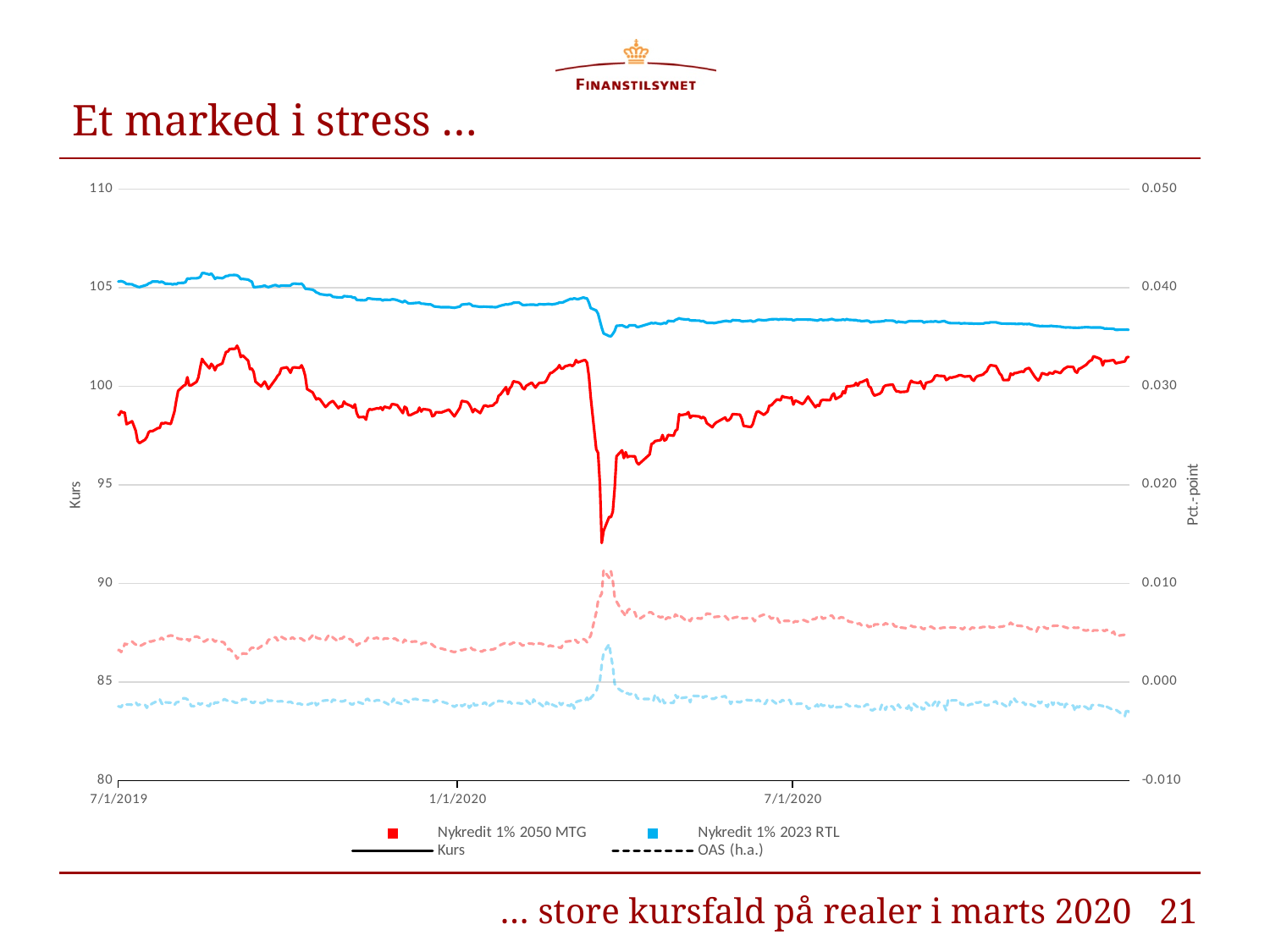
Which bond has the higher Kurs throughout the period, Nykredit 1% 2050 MTG or Nykredit 1% 2023 RTL? Nykredit 1% 2023 RTL What is the label of the right vertical axis? Pct.-point Which bond's Kurs fell more sharply in March 2020, Nykredit 1% 2050 MTG or Nykredit 1% 2023 RTL? Nykredit 1% 2050 MTG Is the lowest Kurs reached by Nykredit 1% 2050 MTG in March 2020 greater or less than 95? less Does the Kurs of Nykredit 1% 2023 RTL rise or fall from 7/1/2019 to 1/1/2020? fall Does the Kurs of Nykredit 1% 2050 MTG rise or fall from its March 2020 low to the end of the period? rise Is the Kurs of Nykredit 1% 2050 MTG at 7/1/2020 greater or less than 100? less What kind of chart is shown on the slide? line chart Is the Kurs of Nykredit 1% 2023 RTL at 7/1/2020 greater or less than 100? greater How many bonds does the chart legend list? 2 What is the label of the left vertical axis? Kurs